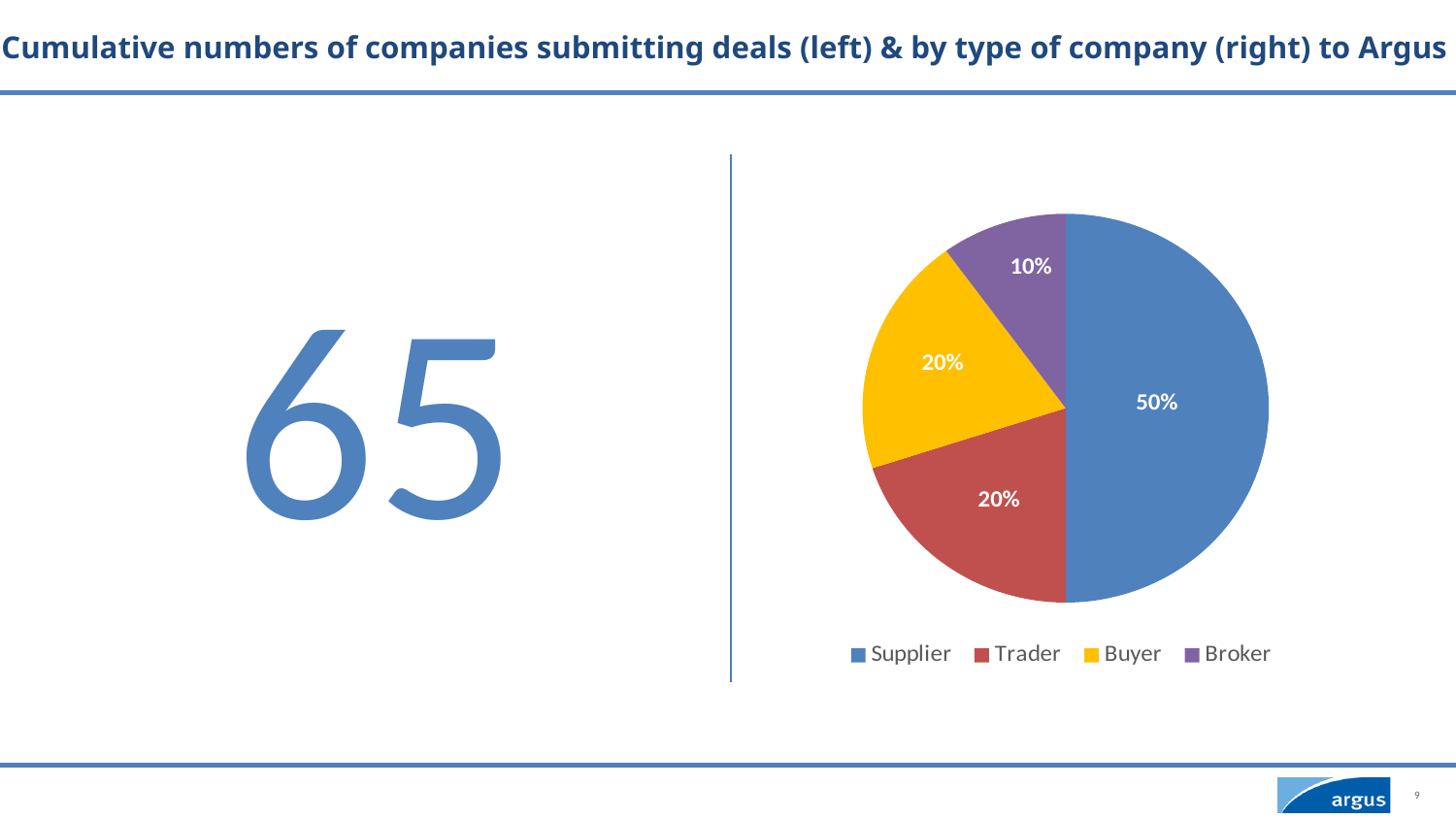
What colour is the Supplier slice in the pie chart? Blue What is the difference in percentage points between the Supplier and Broker slices? 40 How many entries does the pie chart's legend list? 4 Which slice is larger, Supplier or Buyer? Supplier What percentage of the pie chart is Broker? 10% What kind of chart is shown on the right of the slide? Pie chart What percentage of the pie chart is Trader? 20% Which type of company has the largest share of the pie chart? Supplier What percentage of the pie chart is Supplier? 50% Which type of company has the smallest share of the pie chart? Broker What percentage of the pie chart is Buyer? 20% How many slices does the pie chart have? 4